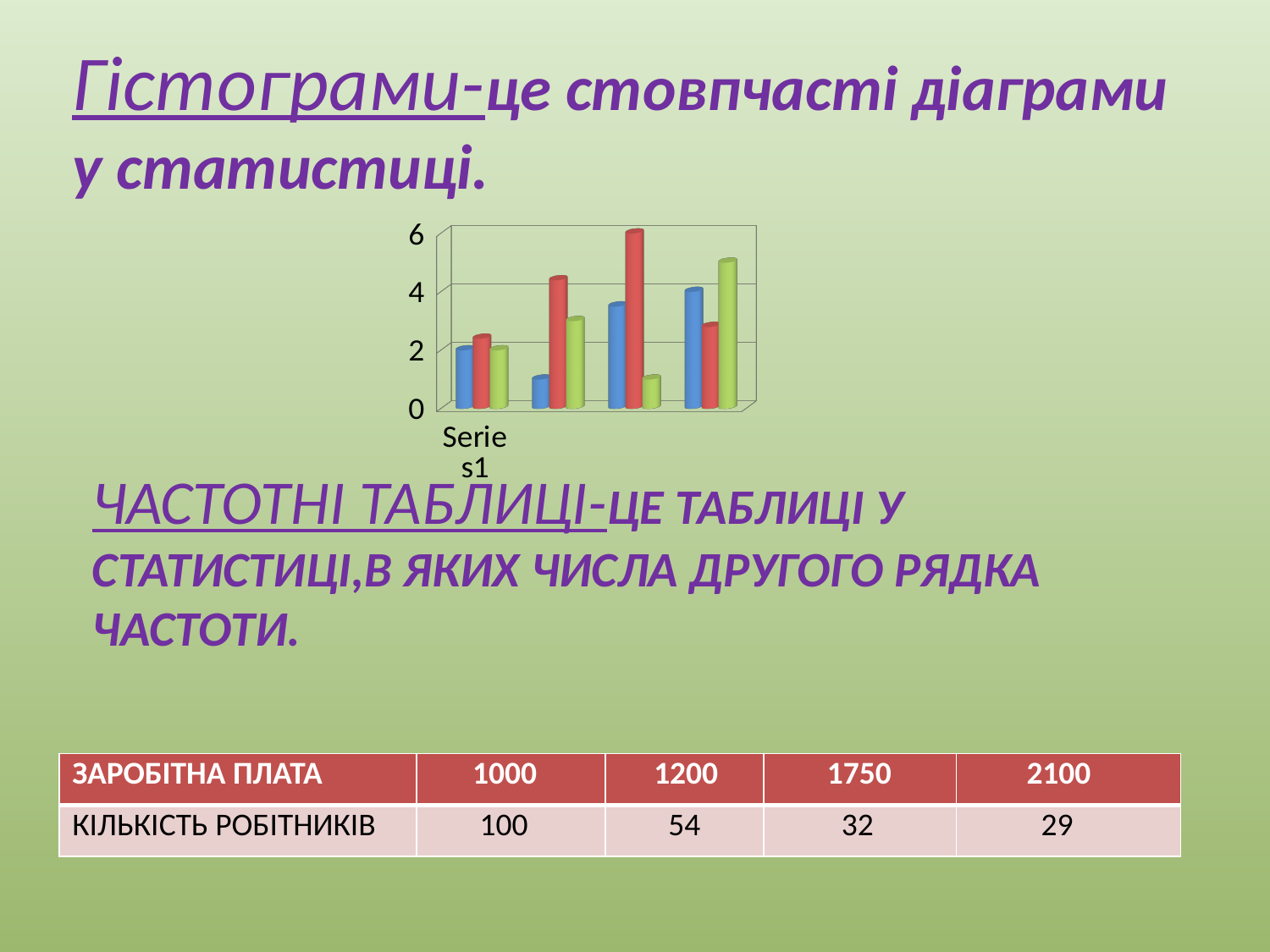
Is the value of the red bar in the first group (Series1) greater or less than 4? less In the fourth group of bars, which is larger: the green bar or the red bar? green bar How many different bar colours (series) are plotted in the chart? 3 Is the value of the tallest red bar (in the third group) greater or less than 4? greater What category label is printed under the first group of bars? Series1 Is the value of the blue bar in the second group greater or less than 2? less How many groups of bars does the chart show? 4 In the second group of bars, which is larger: the red bar or the blue bar? red bar In the third group of bars, which is larger: the red bar or the green bar? red bar What kind of chart is shown on the slide? bar chart Which colour of bar reaches the highest value anywhere on the chart? red What is the highest value shown on the chart's vertical axis? 6